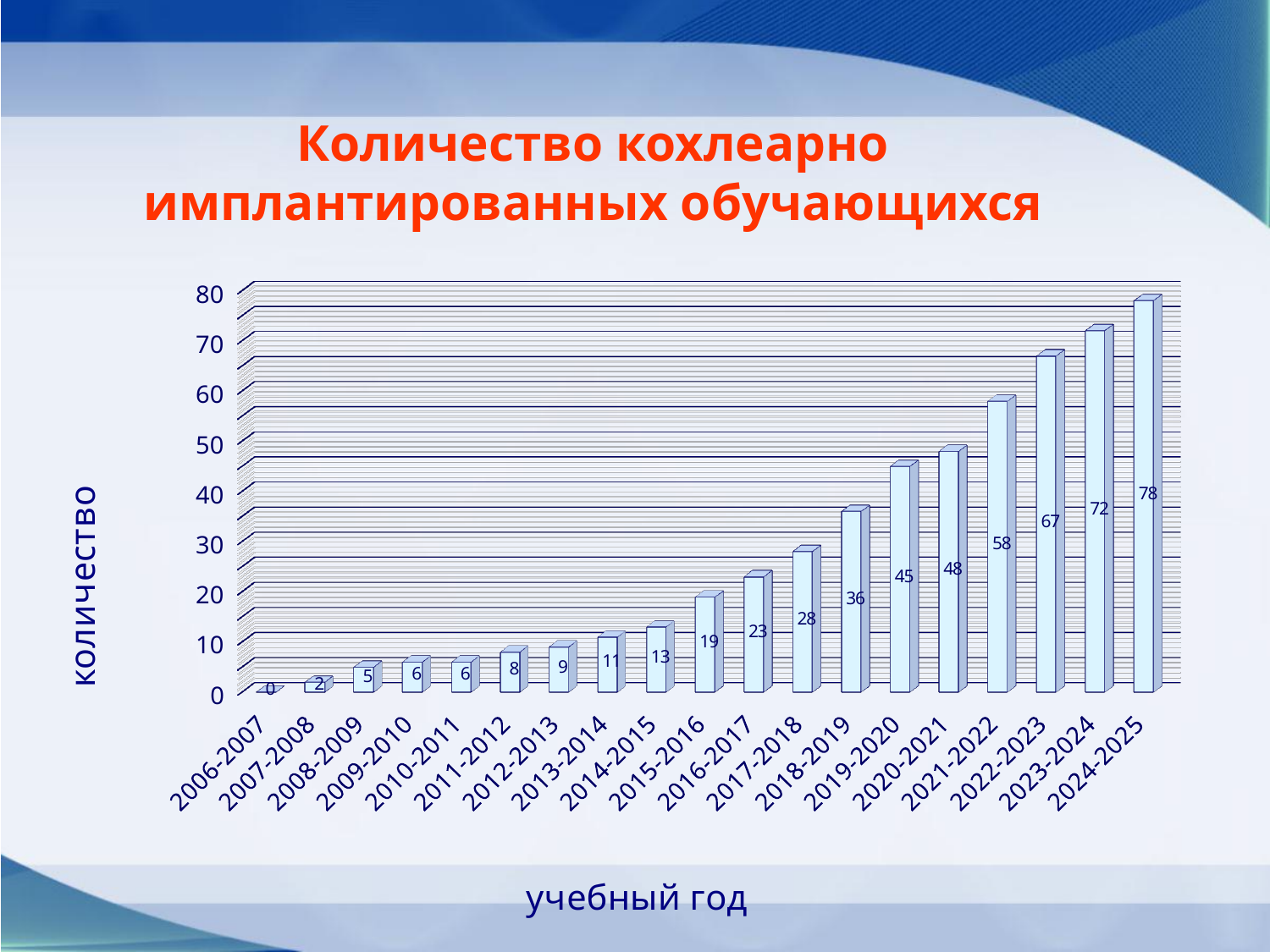
What is the value for 2015-2016? 19 What is the label of the x axis? учебный год Do the values rise or fall from 2006-2007 to 2024-2025? rise What kind of chart is shown on the slide? bar chart What is the difference between the values for 2024-2025 and 2023-2024? 6 What is the value for 2019-2020? 45 How many academic years are shown on the x axis? 19 Which is larger, the value for 2017-2018 or the value for 2016-2017? 2017-2018 What is the difference between the values for 2021-2022 and 2018-2019? 22 Which academic year has the highest value? 2024-2025 What is the value for 2024-2025? 78 Which academic year has the lowest value? 2006-2007